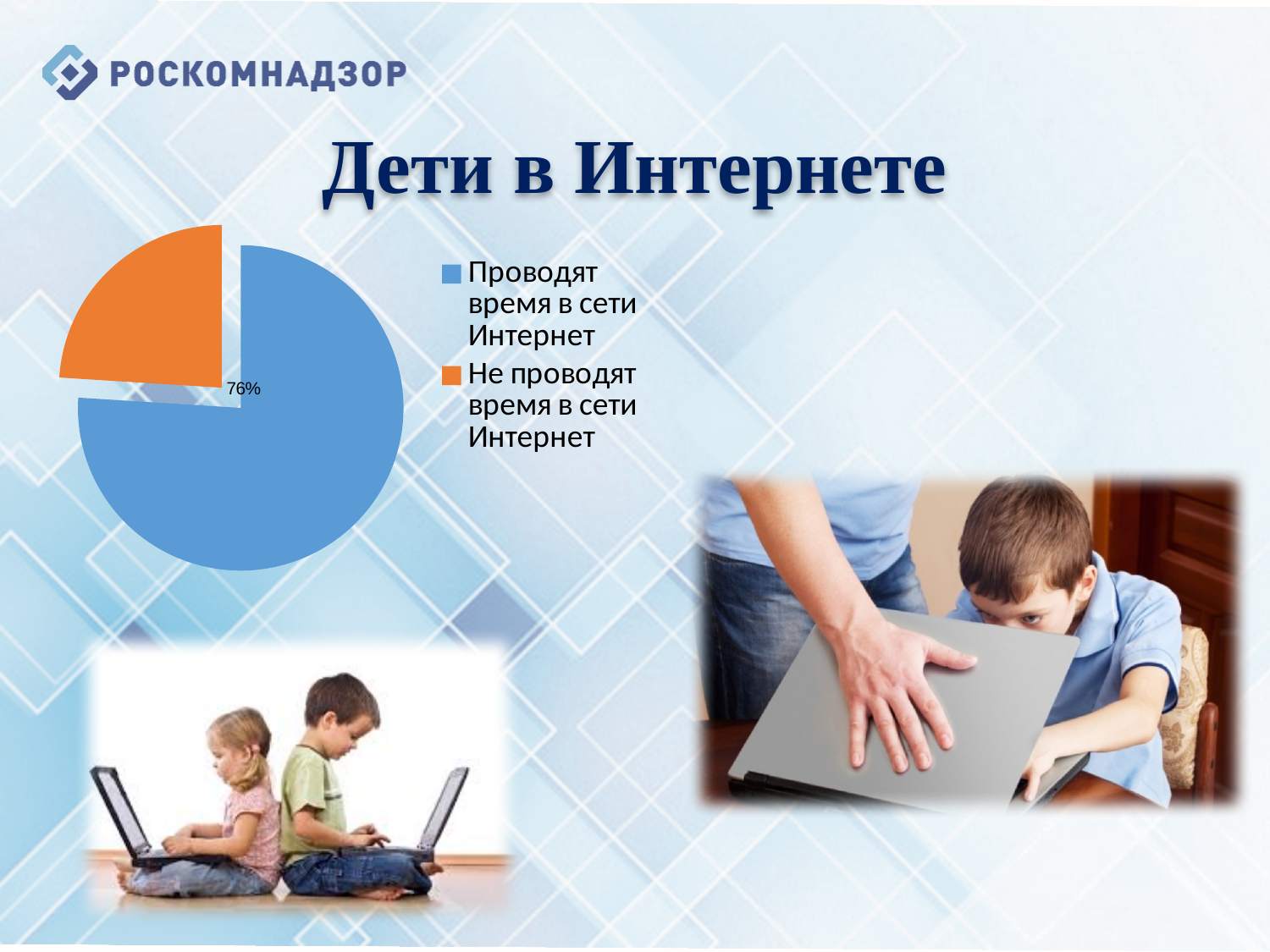
What colour is the "Проводят время в сети Интернет" slice in the pie chart? blue Which category has the largest slice in the pie chart? Проводят время в сети Интернет How many slices does the pie chart have? 2 What colour is the "Не проводят время в сети Интернет" slice in the pie chart? orange Is the value for "Проводят время в сети Интернет" greater or less than 50%? greater How many entries does the legend of the pie chart list? 2 What kind of chart is shown on the slide? pie chart What share of the pie does the "Проводят время в сети Интернет" slice take? 76% What percentage is shown for the slice "Проводят время в сети Интернет"? 76% Which category has the smallest slice in the pie chart? Не проводят время в сети Интернет Which slice is larger: "Проводят время в сети Интернет" or "Не проводят время в сети Интернет"? Проводят время в сети Интернет